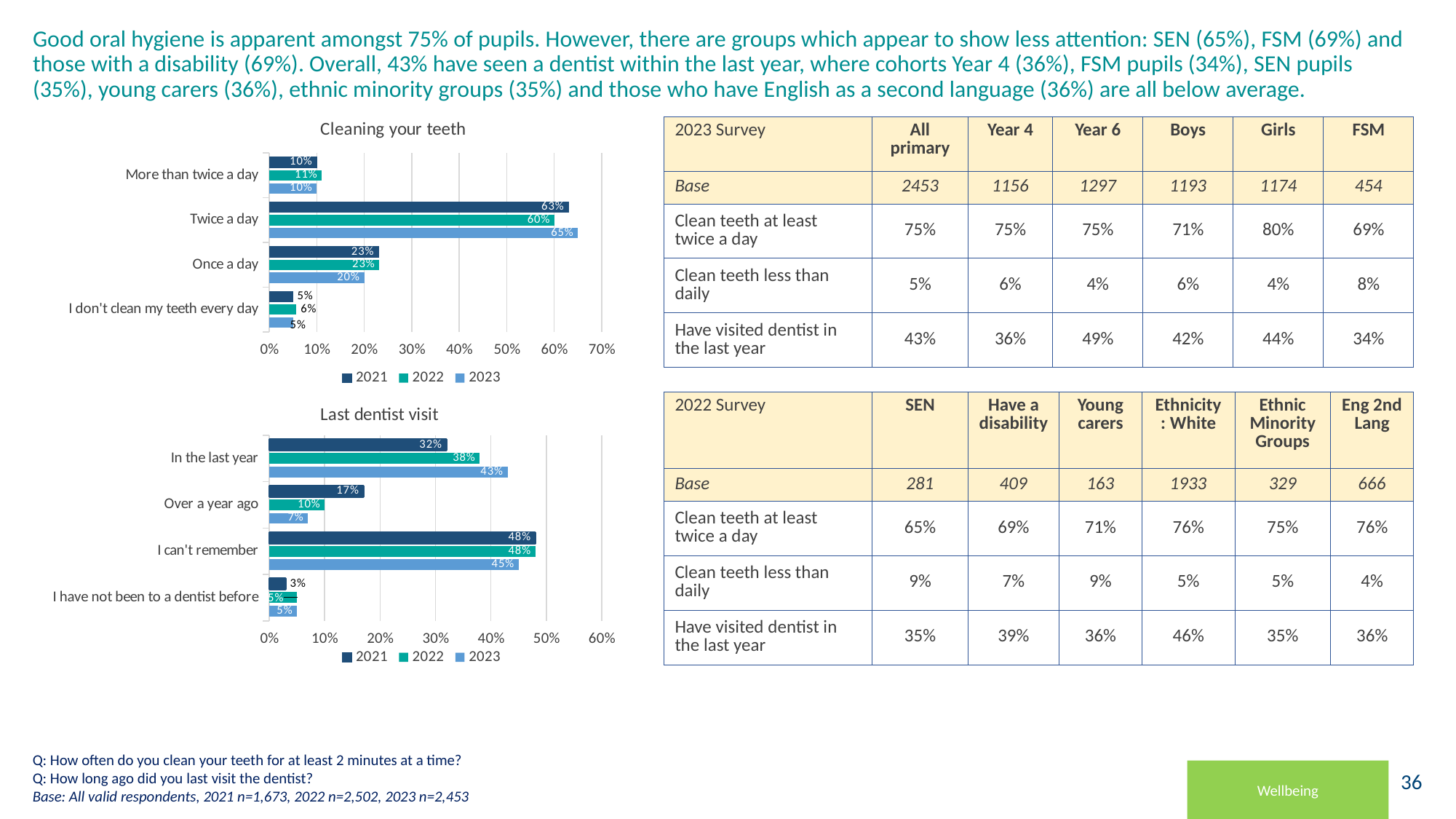
In the 'Last dentist visit' chart, what is the difference between the 2023 and 2021 values for 'In the last year'? 11% In the 'Last dentist visit' chart, which category has the lowest value for 2021? I have not been to a dentist before In the 'Cleaning your teeth' chart, how many series does the legend list? 3 What type of chart is the 'Last dentist visit' chart? Bar chart In the 'Cleaning your teeth' chart, what is the 2023 value for 'Twice a day'? 65% In the 'Last dentist visit' chart, is the 2023 value for 'I can't remember' larger or smaller than the 2021 value? smaller In the 'Cleaning your teeth' chart, what is the difference between the 2023 and 2022 values for 'Twice a day'? 5% In the 'Last dentist visit' chart, what is the 2021 value for 'Over a year ago'? 17% In the 'Cleaning your teeth' chart, what is the 2021 value for 'Once a day'? 23% In the 'Cleaning your teeth' chart, which category has the highest value for 2022? Twice a day In the 'Last dentist visit' chart, how many categories are shown on the vertical axis? 4 In the 'Last dentist visit' chart, what is the 2023 value for 'In the last year'? 43%